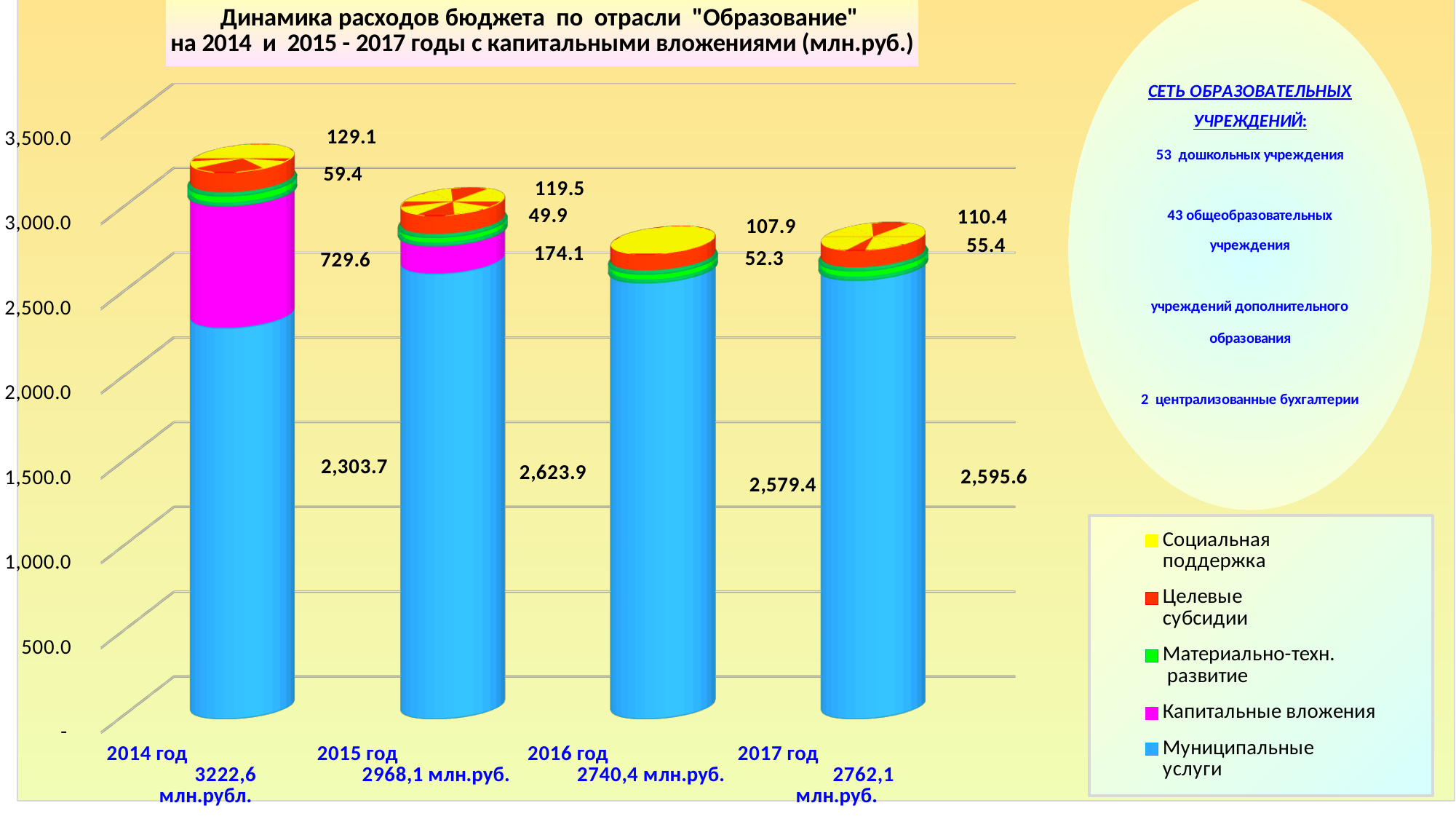
How many series does the legend list? 5 Which year has the larger value of Муниципальные услуги, 2016 год or 2017 год? 2017 год What kind of chart is shown on the slide? Stacked bar chart What is the value of Муниципальные услуги for 2014 год? 2,303.7 What is the value of Целевые субсидии for 2016 год? 107.9 In which year is the value of Материально-техн. развитие the lowest? 2015 год What is the value of Капитальные вложения for 2015 год? 174.1 What is the value of Материально-техн. развитие for 2017 год? 55.4 What is the difference between Капитальные вложения in 2014 год and 2015 год? 555.5 In which year is the value of Муниципальные услуги the highest? 2015 год How many years (categories) are shown on the x axis? 4 What is the total budget expenditure shown for 2014 год? 3222,6 млн.рубл.